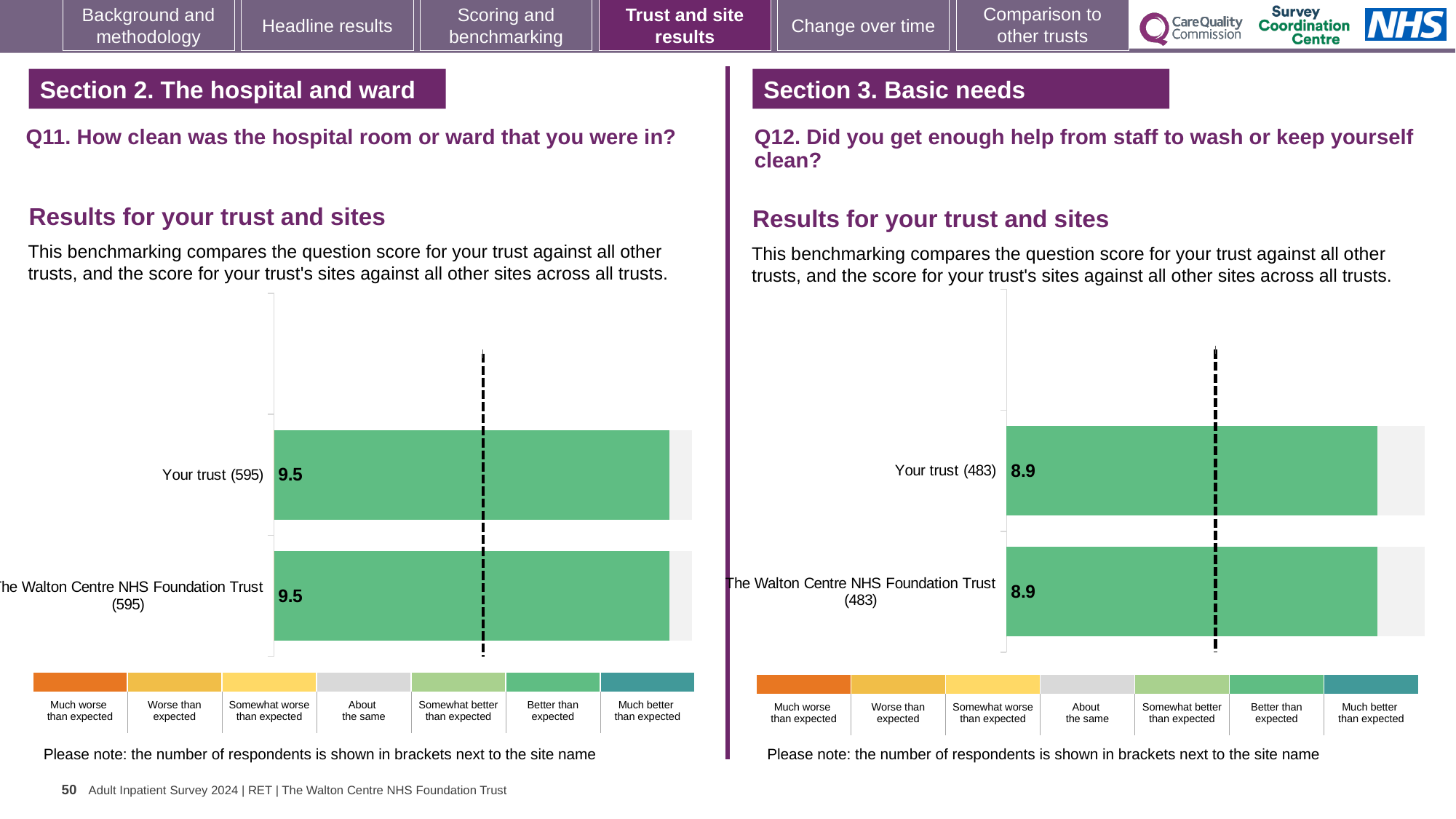
In the Q12 chart on the right, what is the score for The Walton Centre NHS Foundation Trust? 8.9 In the Q12 chart on the right, what is the score for Your trust? 8.9 What kind of chart is used for the Q11 results on the left? Bar chart In the Q11 chart on the left, what is the difference between the score for Your trust and the score for The Walton Centre NHS Foundation Trust? 0.0 In the Q12 chart on the right, what is the difference between the score for Your trust and the score for The Walton Centre NHS Foundation Trust? 0.0 In the Q12 chart on the right, how many bars are plotted? 2 In the Q11 chart on the left, how many bars are plotted? 2 In the Q11 chart on the left, what is the score for Your trust? 9.5 In the Q12 chart on the right, how many respondents are shown in brackets next to Your trust? 483 In the Q11 chart on the left, what is the score for The Walton Centre NHS Foundation Trust? 9.5 In the Q11 chart on the left, how many respondents are shown in brackets next to Your trust? 595 According to the colour key below the Q12 chart on the right, which benchmark category does the green colour of the bars represent? Better than expected